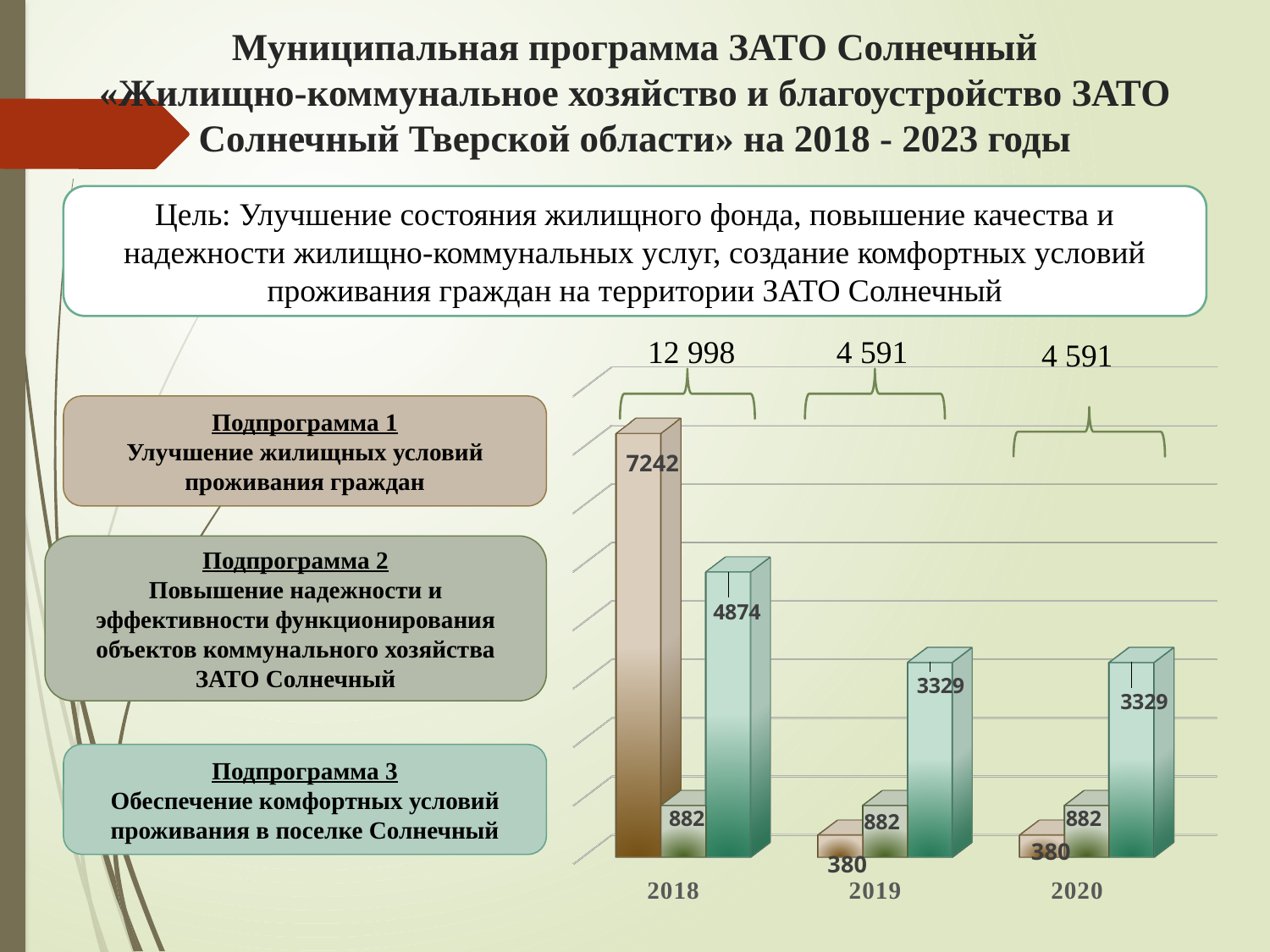
What is the value of the brown bar (Подпрограмма 1) for 2020? 380 What kind of chart is shown on the slide? Bar chart In 2018, which is larger: the brown bar or the teal bar? The brown bar (7242) What total is shown above the group of bars for 2019? 4 591 What is the value of the teal bar (Подпрограмма 3) for 2019? 3329 How many years are shown on the x axis of the chart? 3 What is the value of the brown bar (Подпрограмма 1) for 2018? 7242 What is the value of the grey-green bar (Подпрограмма 2) for 2020? 882 What total is shown above the group of bars for 2018? 12 998 In which year is the brown bar (Подпрограмма 1) highest? 2018 By how much does the teal bar (Подпрограмма 3) decrease from 2018 to 2019? 1545 What is the difference between the brown bar and the teal bar in 2018? 2368